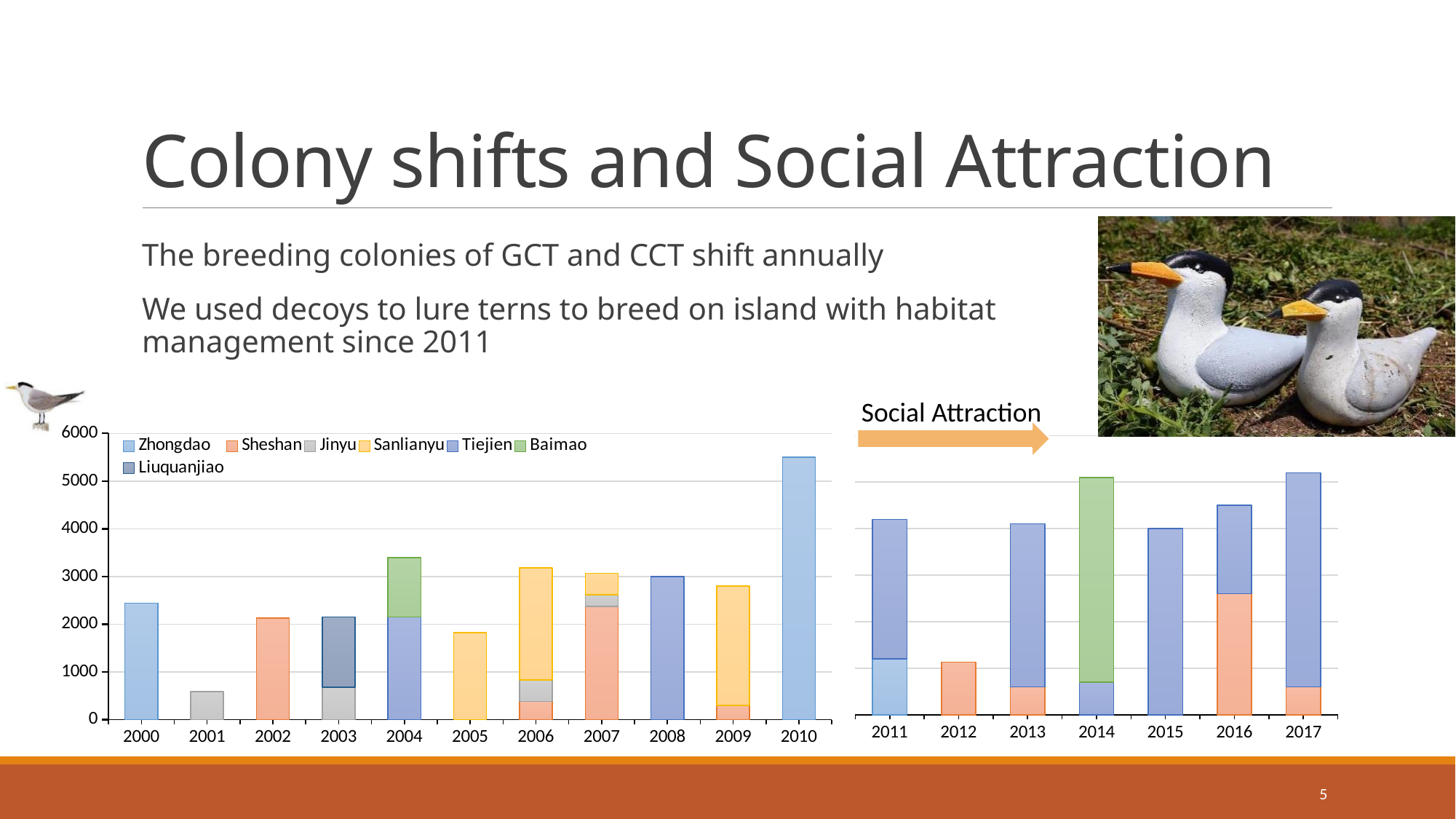
Which year has the larger total bar, 2013 or 2016? 2016 Which year has the tallest bar in the chart? 2010 Is the total value for 2010 greater or less than 5000? greater Is the value for 2001 greater or less than 1000? less How many series does the chart's legend list? 7 Is the total value for 2004 greater or less than 3000? greater How many years are shown along the x axis of the chart? 18 Do the total bar values rise or fall from 2015 to 2017? rise What kind of chart is shown on the slide? bar chart Which year has the shortest bar in the chart? 2001 Which series in the legend is shown in green? Baimao Which year has the larger bar, 2011 or 2012? 2011